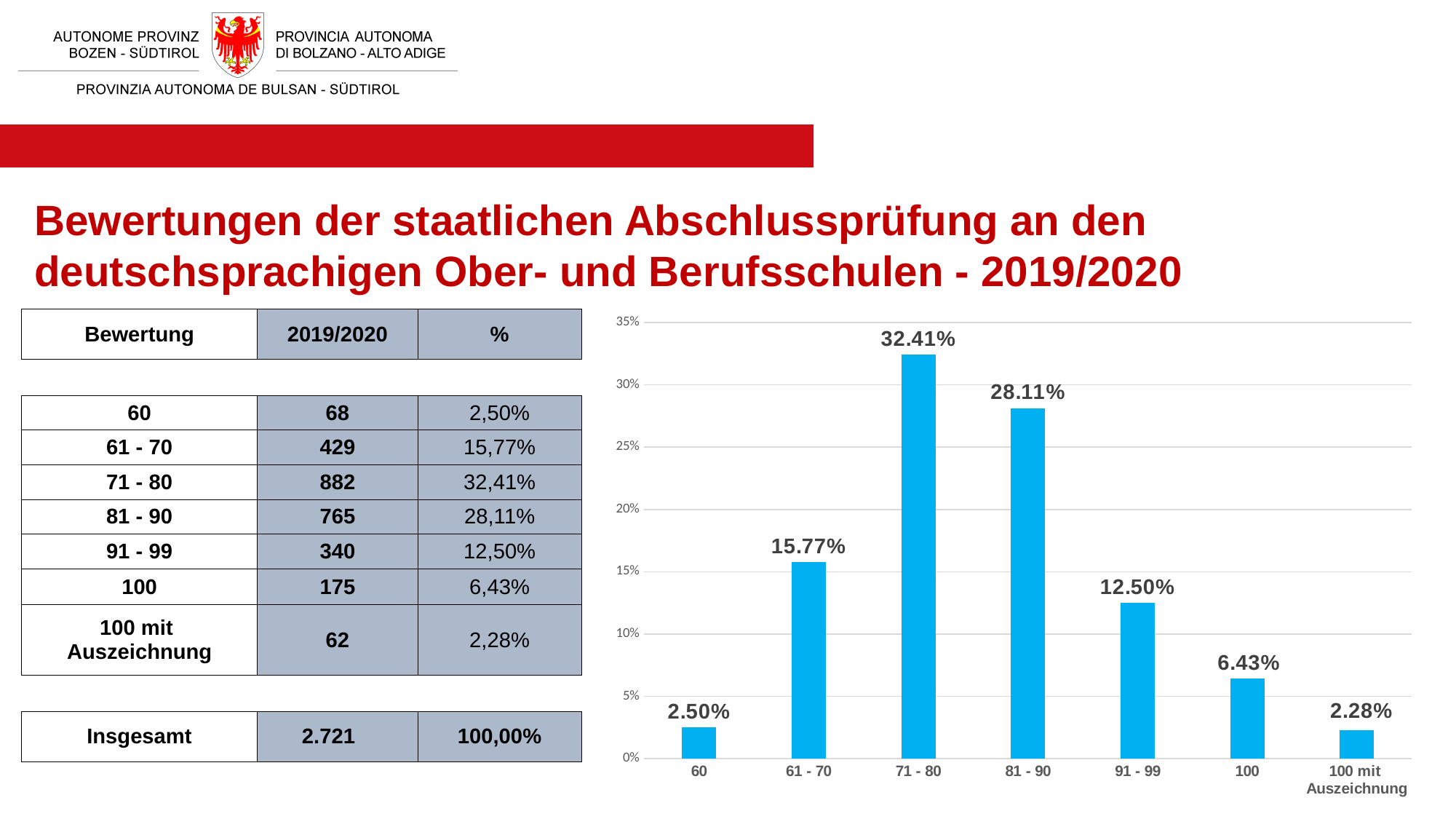
What is the difference between the values for 60 and 100 mit Auszeichnung in the bar chart? 0.22% Which category has the highest value in the bar chart? 71 - 80 What is the value shown for the 71 - 80 category in the bar chart? 32.41% Which category has the lowest value in the bar chart? 100 mit Auszeichnung What kind of chart is shown on the slide? bar chart What is the highest value labelled on the y axis of the bar chart? 35% What is the value shown for the 61 - 70 category in the bar chart? 15.77% How many categories are shown on the x axis of the bar chart? 7 Is the value for 81 - 90 in the bar chart greater or less than 25%? greater Which is larger in the bar chart, the value for 91 - 99 or the value for 61 - 70? 61 - 70 What is the difference between the values for 71 - 80 and 81 - 90 in the bar chart? 4.30% What is the value shown for the 100 category in the bar chart? 6.43%